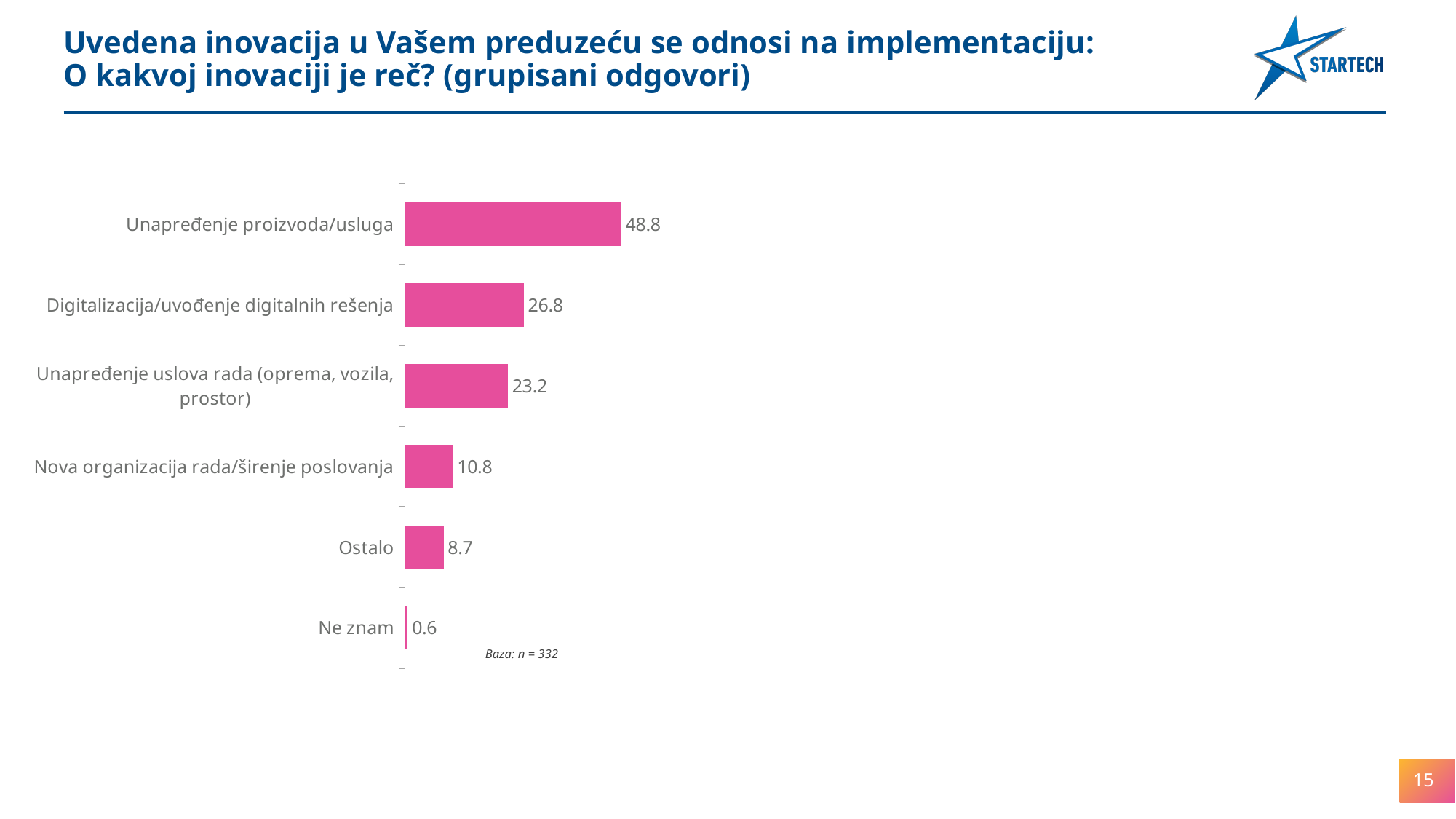
What is the value for Digitalizacija/uvođenje digitalnih rešenja? 26.8 What is the difference between the values for Unapređenje proizvoda/usluga and Digitalizacija/uvođenje digitalnih rešenja? 22.0 How many categories are shown in the chart? 6 What base size (n) is noted below the chart? n = 332 What is the value for Unapređenje proizvoda/usluga? 48.8 Which category has the highest value? Unapređenje proizvoda/usluga Which category has the lowest value? Ne znam What is the value for Ne znam? 0.6 What is the difference between the values for Nova organizacija rada/širenje poslovanja and Ostalo? 2.1 What kind of chart is shown on the slide? Bar chart Which is larger: the value for Digitalizacija/uvođenje digitalnih rešenja or the value for Unapređenje uslova rada (oprema, vozila, prostor)? Digitalizacija/uvođenje digitalnih rešenja What is the value for Nova organizacija rada/širenje poslovanja? 10.8